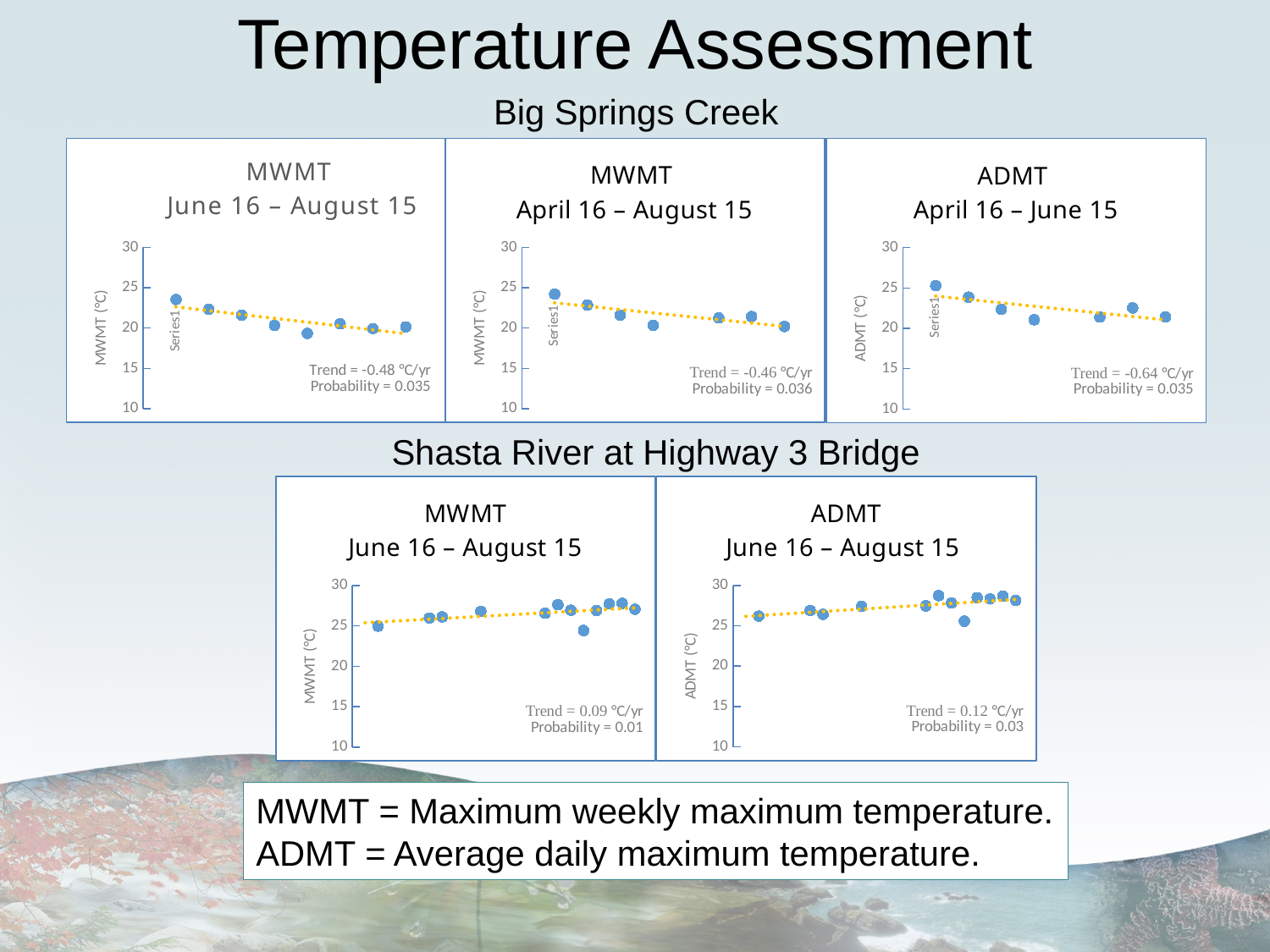
In the Big Springs Creek MWMT June 16 – August 15 chart, what is the printed trend value? -0.48 °C/yr In the Big Springs Creek ADMT April 16 – June 15 chart, what is the printed probability? 0.035 In the Big Springs Creek MWMT April 16 – August 15 chart, what is the printed trend value? -0.46 °C/yr In the Big Springs Creek ADMT April 16 – June 15 chart, do the values rise or fall along the x axis? fall What is the y-axis label of the Shasta River at Highway 3 Bridge ADMT chart? ADMT (°C) In the Shasta River at Highway 3 Bridge ADMT chart, do the values rise or fall along the x axis? rise Which chart has the steeper negative trend: Big Springs Creek MWMT April 16 – August 15 or Big Springs Creek ADMT April 16 – June 15? ADMT April 16 – June 15 What kind of chart is the Big Springs Creek MWMT June 16 – August 15 chart? scatter chart In the Big Springs Creek MWMT June 16 – August 15 chart, what is the printed probability? 0.035 In the Shasta River at Highway 3 Bridge MWMT chart, what is the printed trend value? 0.09 °C/yr In the Shasta River at Highway 3 Bridge MWMT chart, are the plotted values greater or less than 20? greater In the Shasta River at Highway 3 Bridge ADMT chart, what is the printed probability? 0.03